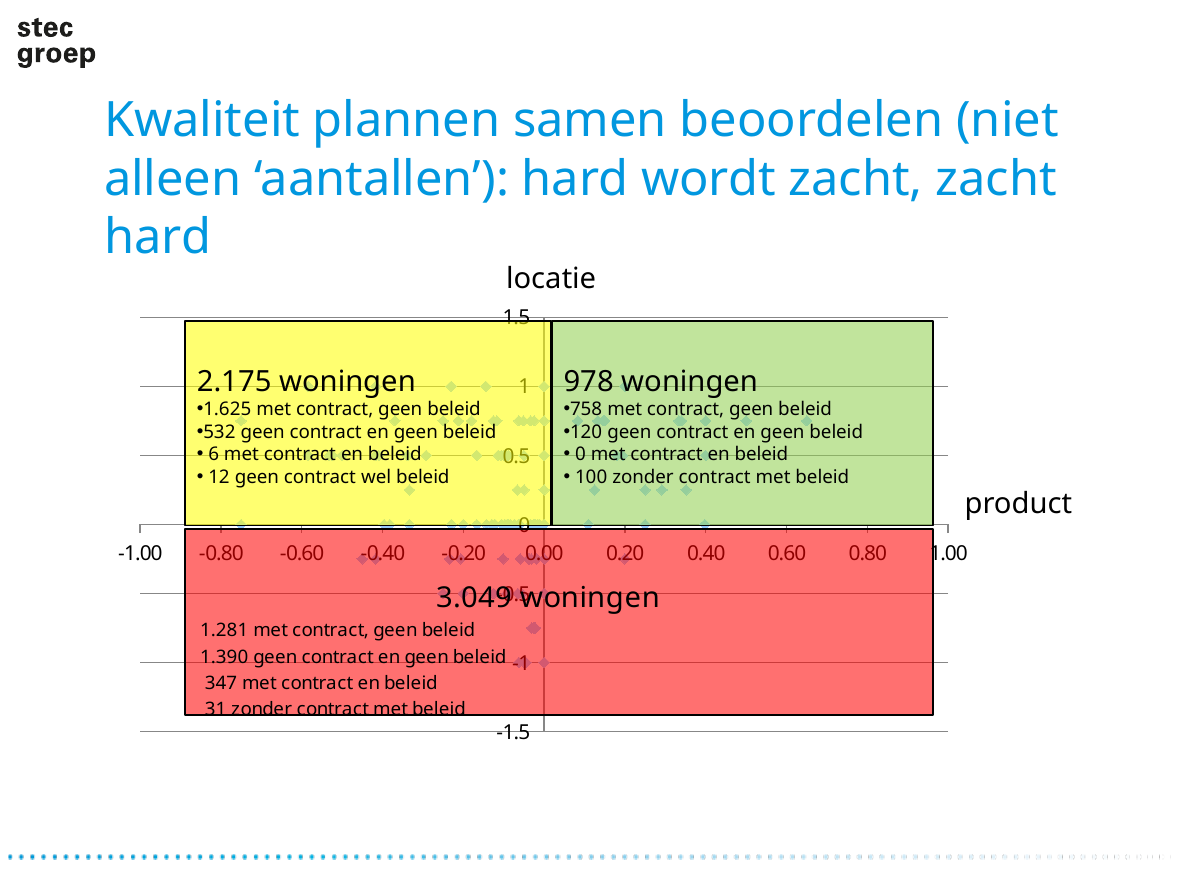
Which coloured quadrant of the chart has the highest number of woningen? the red bottom quadrant (3.049 woningen) How many woningen are reported in the red bottom quadrant of the chart? 3.049 woningen What is the label of the horizontal axis of the chart? product In the green quadrant, how many woningen are listed as 'met contract, geen beleid'? 758 How many woningen are reported in the yellow top-left quadrant of the chart? 2.175 woningen How many woningen are reported in the green top-right quadrant of the chart? 978 woningen In the yellow quadrant, how many woningen are listed as 'geen contract en geen beleid'? 532 What kind of chart is shown on the slide? scatter chart In the red quadrant, how many woningen are listed as 'met contract en beleid'? 347 What is the difference between the number of woningen in the yellow quadrant and the green quadrant? 1.197 Which coloured quadrant of the chart has the lowest number of woningen? the green top-right quadrant (978 woningen) What is the label of the vertical axis of the chart? locatie